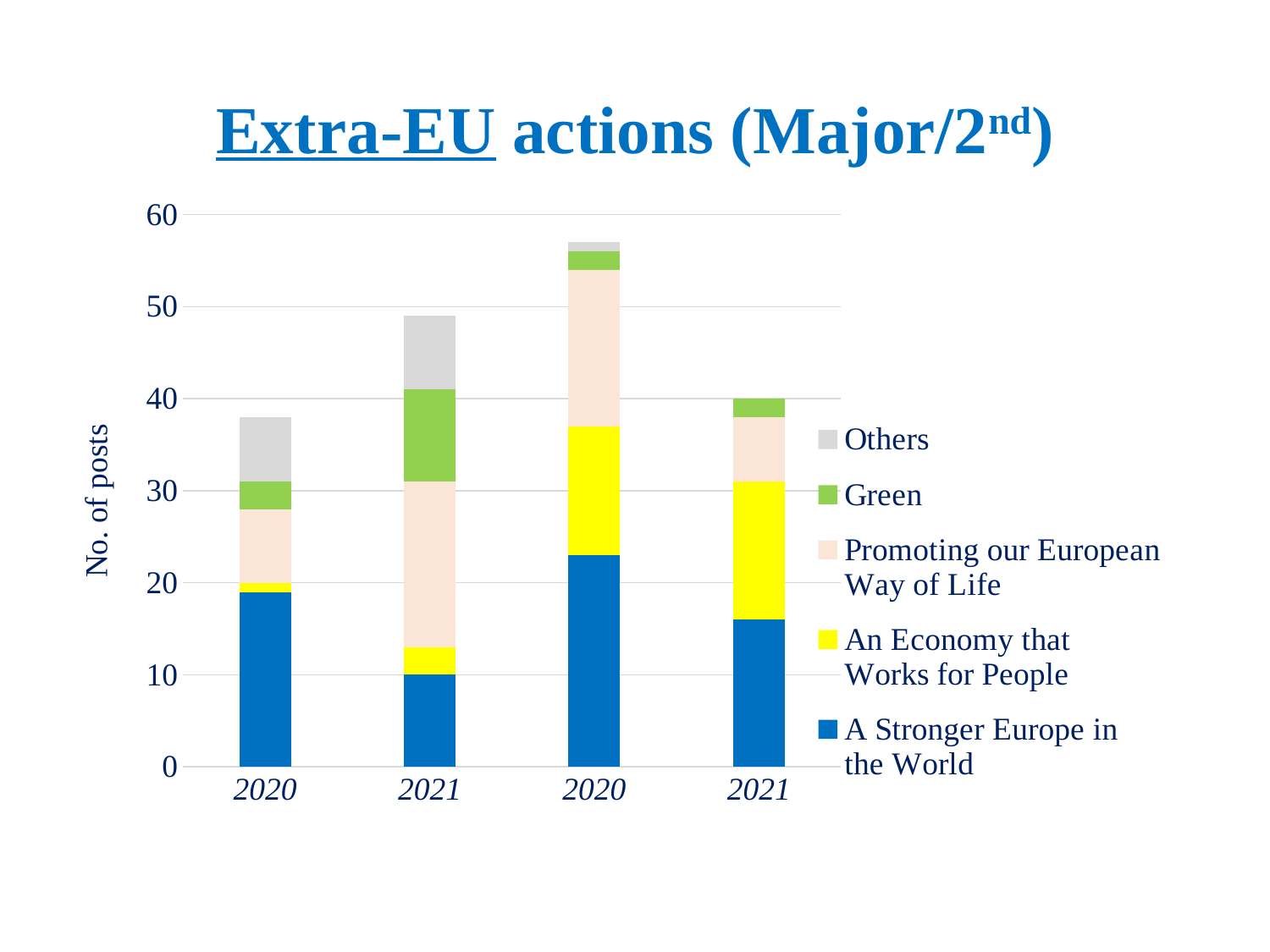
Is the total for the third bar (second 2020) greater or less than 50? greater How many series does the legend list? 5 What is the label on the vertical axis of the chart? No. of posts Which bar has the highest total number of posts? The third bar (second 2020) Is the total for the second bar (first 2021) greater or less than 40? greater Is the 'A Stronger Europe in the World' segment of the third bar (second 2020) greater or less than 20? greater What kind of chart is shown on the slide? Stacked bar chart How many bars are plotted in the chart? 4 Which bar has the larger 'A Stronger Europe in the World' segment, the first bar (first 2020) or the second bar (first 2021)? The first bar (first 2020) Which bar has the larger total, the second bar (first 2021) or the fourth bar (second 2021)? The second bar (first 2021)